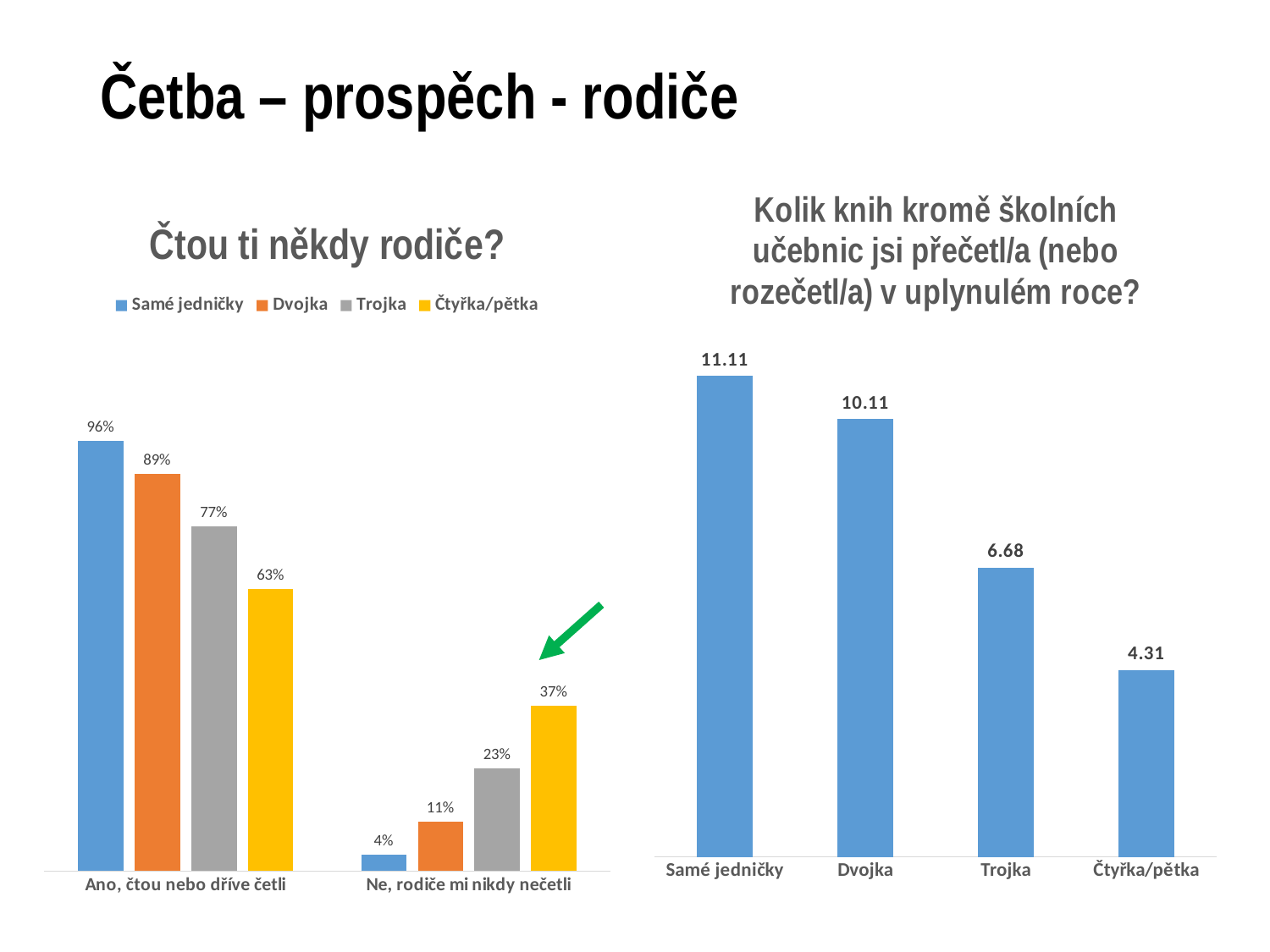
In the chart 'Kolik knih kromě školních učebnic jsi přečetl/a (nebo rozečetl/a) v uplynulém roce?', what is the value for 'Trojka'? 6.68 In the chart 'Čtou ti někdy rodiče?', what is the value for 'Čtyřka/pětka' in the category 'Ne, rodiče mi nikdy nečetli'? 37% In the chart 'Čtou ti někdy rodiče?', how many series does the legend list? 4 In the chart 'Čtou ti někdy rodiče?', what is the value for 'Samé jedničky' in the category 'Ano, čtou nebo dříve četli'? 96% In the chart 'Kolik knih kromě školních učebnic jsi přečetl/a (nebo rozečetl/a) v uplynulém roce?', how many categories are shown? 4 In the chart 'Čtou ti někdy rodiče?', which is larger in the category 'Ne, rodiče mi nikdy nečetli': 'Dvojka' or 'Trojka'? Trojka In the chart 'Čtou ti někdy rodiče?', which series has the lowest value in the category 'Ne, rodiče mi nikdy nečetli'? Samé jedničky In the chart 'Čtou ti někdy rodiče?', what colour represents the series 'Dvojka'? Orange In the chart 'Kolik knih kromě školních učebnic jsi přečetl/a (nebo rozečetl/a) v uplynulém roce?', what is the difference between 'Samé jedničky' and 'Čtyřka/pětka'? 6.80 In the chart 'Kolik knih kromě školních učebnic jsi přečetl/a (nebo rozečetl/a) v uplynulém roce?', do the values rise or fall from left to right? Fall In the chart 'Čtou ti někdy rodiče?', what is the difference between 'Samé jedničky' and 'Čtyřka/pětka' in the category 'Ano, čtou nebo dříve četli'? 33% In the chart 'Kolik knih kromě školních učebnic jsi přečetl/a (nebo rozečetl/a) v uplynulém roce?', which category has the highest value? Samé jedničky